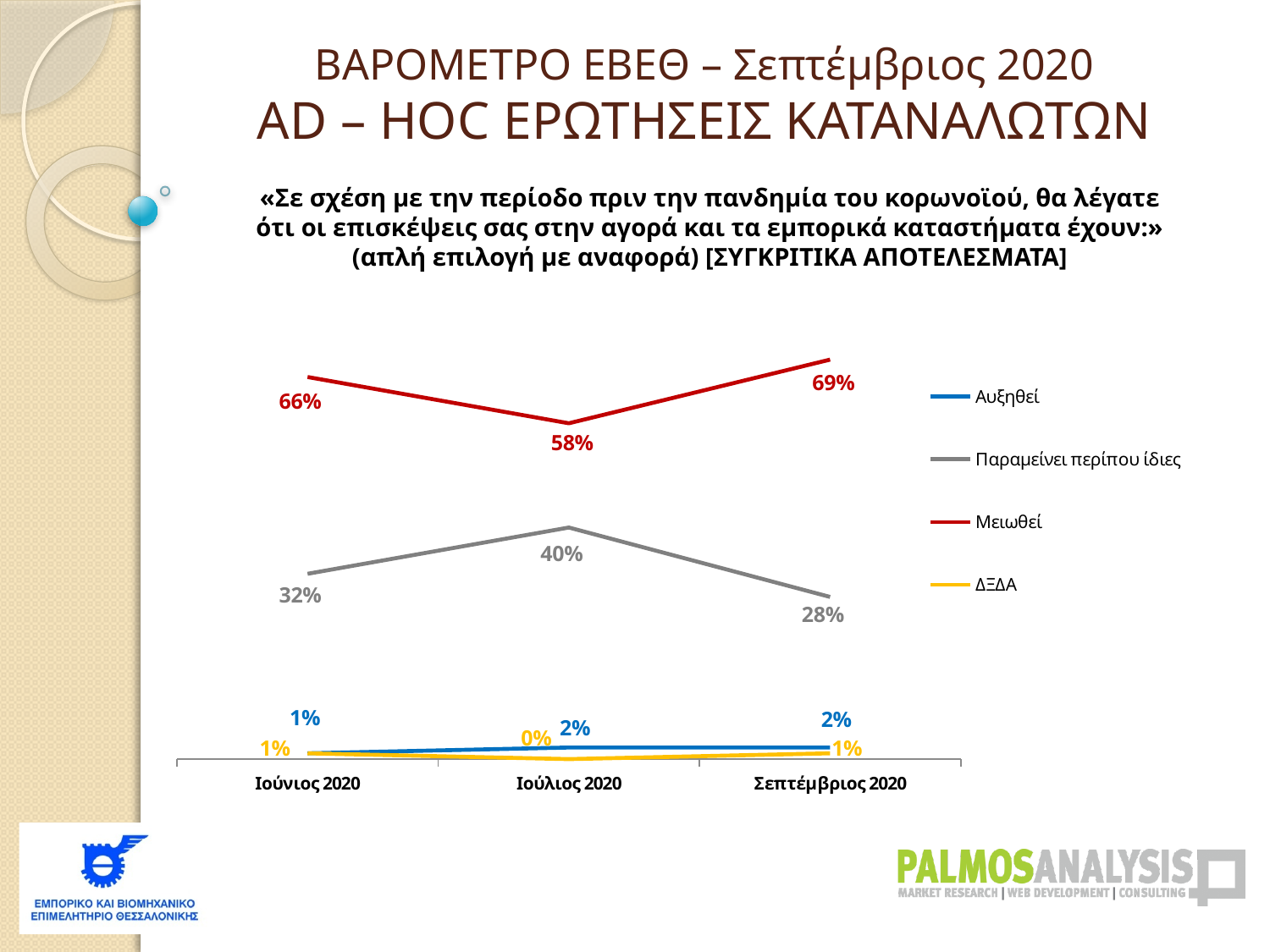
What is the value for Μειωθεί in Ιούλιος 2020? 58% Does the Παραμείνει περίπου ίδιες series rise or fall from Ιούλιος 2020 to Σεπτέμβριος 2020? fall In which month is the value for Παραμείνει περίπου ίδιες lowest? Σεπτέμβριος 2020 What is the value for Παραμείνει περίπου ίδιες in Σεπτέμβριος 2020? 28% How many time points are shown on the x axis? 3 What is the difference between the Μειωθεί values for Σεπτέμβριος 2020 and Ιούλιος 2020? 11% In which month is the value for Μειωθεί highest? Σεπτέμβριος 2020 What colour is the line for Μειωθεί? red How many series does the legend list? 4 What kind of chart is shown on the slide? line chart What is the value for Αυξηθεί in Ιούνιος 2020? 1% Which is larger in Ιούλιος 2020: Μειωθεί or Παραμείνει περίπου ίδιες? Μειωθεί